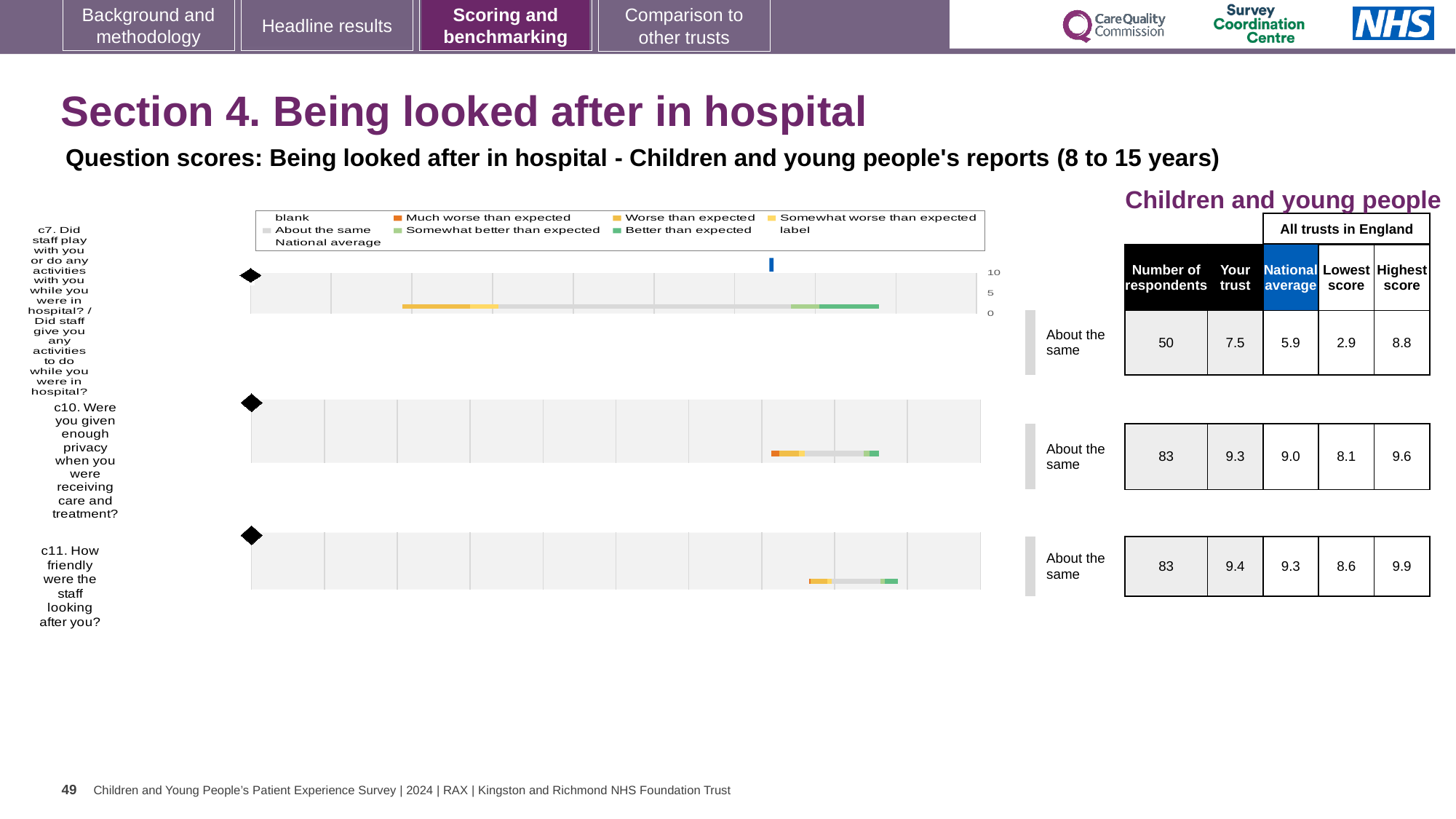
For question c10, which is larger: the 'Your trust' score or the national average? Your trust Which question has the highest 'Your trust' score? c11. How friendly were the staff looking after you? What is the lowest score across all trusts in England for question c7? 2.9 How many questions are charted on this slide? 3 What benchmark category is shown for question c11? About the same What is the difference between the 'Your trust' score and the national average for question c7? 1.6 What is the 'Your trust' score for question c10 (Were you given enough privacy when you were receiving care and treatment?)? 9.3 What kind of chart is used to show the question scores on this slide? Bar chart What is the national average score for question c11 (How friendly were the staff looking after you?)? 9.3 What is the highest score across all trusts in England for question c10? 9.6 Which question has the lowest national average score? c7. Did staff play with you or do any activities with you while you were in hospital? How many respondents answered question c7 (Did staff play with you or do any activities with you while you were in hospital?)? 50